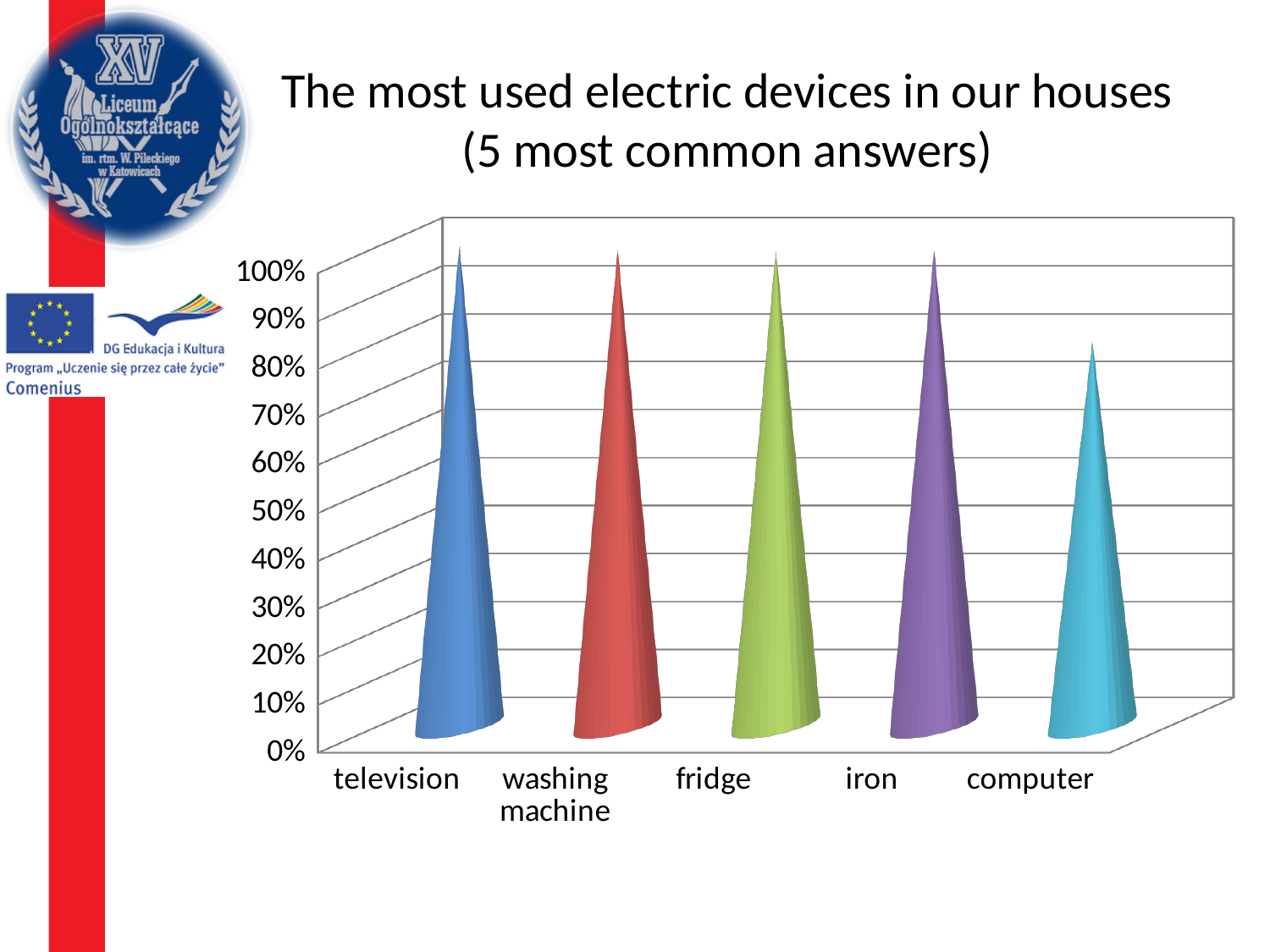
Which device has the lowest value on the chart? computer Which is larger, the value for computer or the value for washing machine? washing machine Which is larger, the value for television or the value for computer? television What kind of chart is shown on the slide? bar chart Which is larger, the value for fridge or the value for computer? fridge Which category is listed first on the horizontal axis? television Is the value for computer greater or less than 90%? less Is the value for iron greater or less than 80%? greater How many electric devices are shown on the chart? 5 What is the highest value shown on the vertical axis of the chart? 100% What is the title of the chart on the slide? The most used electric devices in our houses (5 most common answers) Is the value for television greater or less than 90%? greater